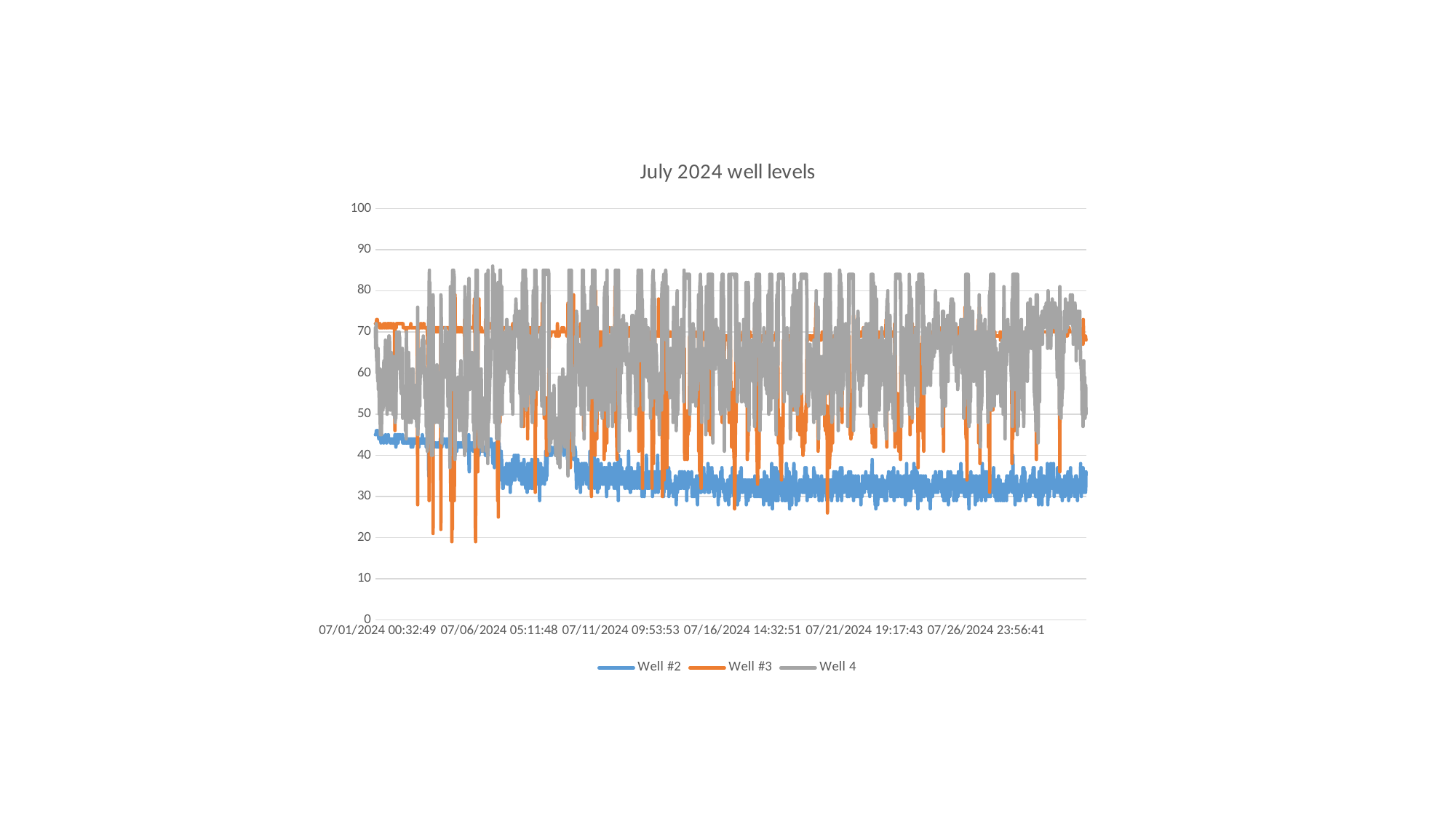
What is the highest value shown on the vertical axis? 100 Which series is drawn in orange? Well #3 Is the value for Well #2 at the start of July greater or less than 50? less Is the value for Well #2 at the end of July greater or less than 40? less How many series does the legend list? 3 Which series reaches the highest values on the chart? Well 4 Do the values for Well #2 rise or fall over the course of July? fall Which series generally has the lowest values throughout the chart? Well #2 What kind of chart is shown on the slide? line chart What is the title of the chart? July 2024 well levels Which series is higher at the end of July, Well #2 or Well #3? Well #3 Is the value for Well #3 at the start of July greater or less than 60? greater